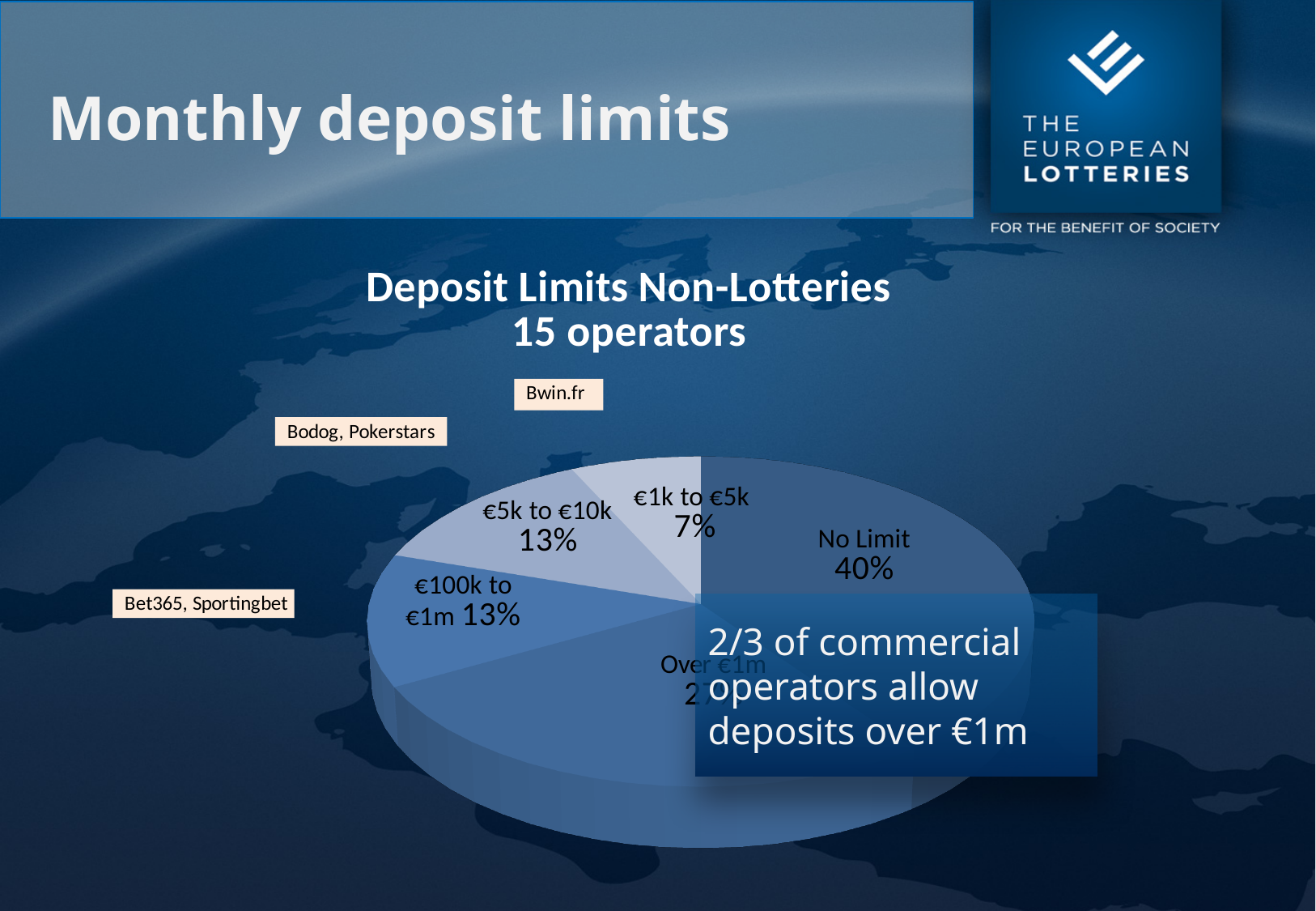
What percentage of operators have No Limit on monthly deposits? 40% What is the difference in percentage points between the No Limit slice and the €5k to €10k slice? 27 percentage points How many slices does the pie chart have? 5 Which category has the largest slice of the pie? No Limit What is the title of the chart? Deposit Limits Non-Lotteries 15 operators Which is larger, the No Limit slice or the €1k to €5k slice? No Limit What percentage is shown for the €100k to €1m category? 13% What percentage is shown for the €5k to €10k category? 13% What share of the pie is the €1k to €5k slice? 7% Which category has the smallest slice of the pie? €1k to €5k How many operators does the chart title say are covered? 15 operators What kind of chart is shown on the slide? Pie chart